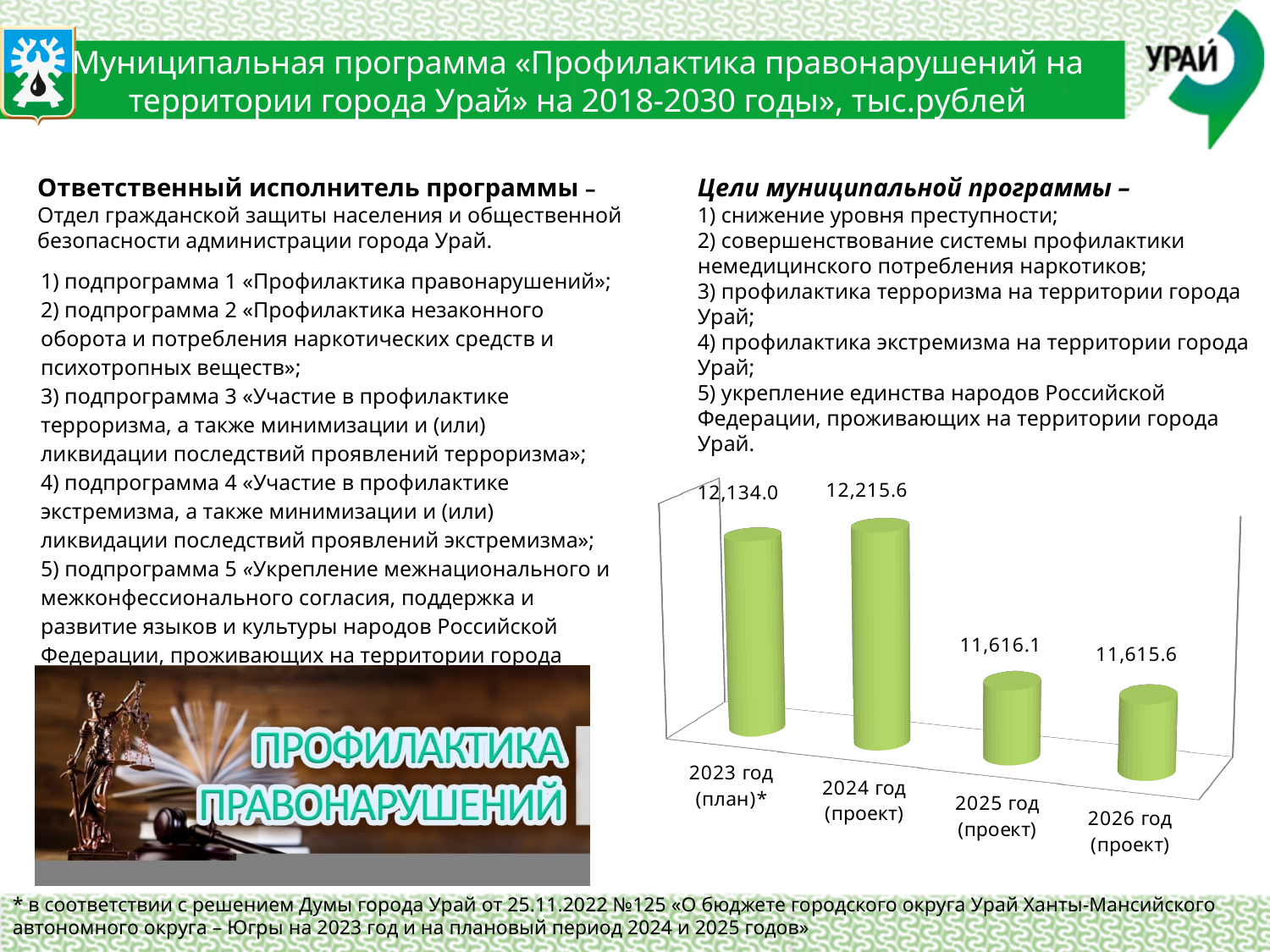
What is the value for 2026 год (проект) on the chart? 11,615.6 How many years are shown on the chart? 4 What is the difference between the values for 2023 год (план)* and 2025 год (проект)? 517.9 What is the value for 2024 год (проект) on the chart? 12,215.6 What is the value for 2023 год (план)* on the chart? 12,134.0 What is the value for 2025 год (проект) on the chart? 11,616.1 What kind of chart is shown on the slide? Bar chart What is the difference between the values for 2024 год (проект) and 2026 год (проект)? 600.0 Which year has the lowest value on the chart? 2026 год (проект) What is the difference between the values for 2024 год (проект) and 2023 год (план)*? 81.6 Which year has the highest value on the chart? 2024 год (проект) Which is larger, the value for 2023 год (план)* or the value for 2025 год (проект)? 2023 год (план)*